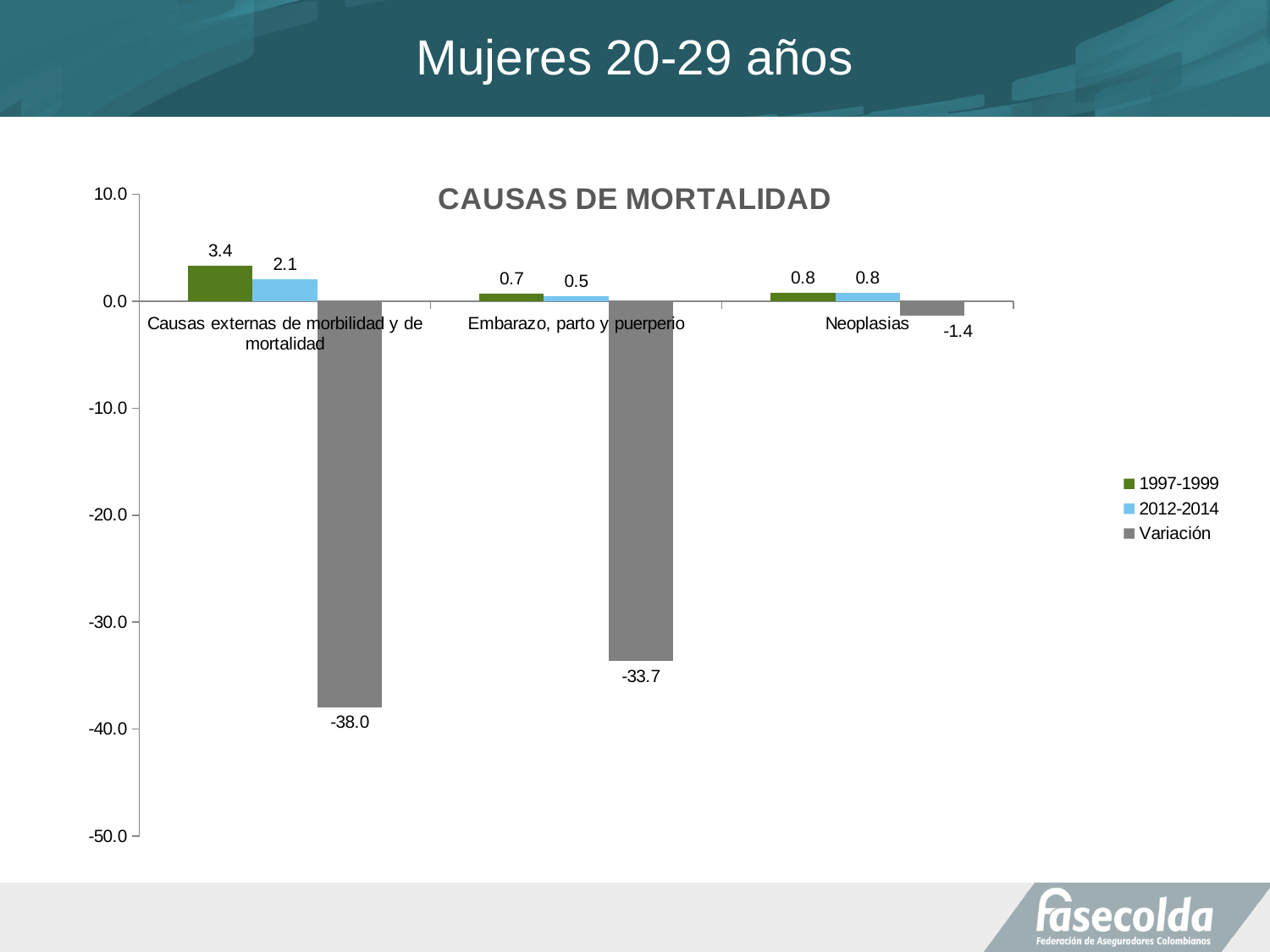
Which category has the highest 1997-1999 value? Causas externas de morbilidad y de mortalidad What is the 2012-2014 value for Embarazo, parto y puerperio? 0.5 How many series does the legend list? 3 How many categories are shown on the x axis? 3 What is the title of the chart? CAUSAS DE MORTALIDAD What kind of chart is shown? Bar chart What is the difference between the 1997-1999 and 2012-2014 values for Causas externas de morbilidad y de mortalidad? 1.3 What is the Variación value for Neoplasias? -1.4 Which category has the lowest Variación value? Causas externas de morbilidad y de mortalidad What is the Variación value for Causas externas de morbilidad y de mortalidad? -38.0 Which is larger, the Variación for Embarazo, parto y puerperio or the Variación for Neoplasias? Neoplasias What is the 1997-1999 value for Causas externas de morbilidad y de mortalidad? 3.4